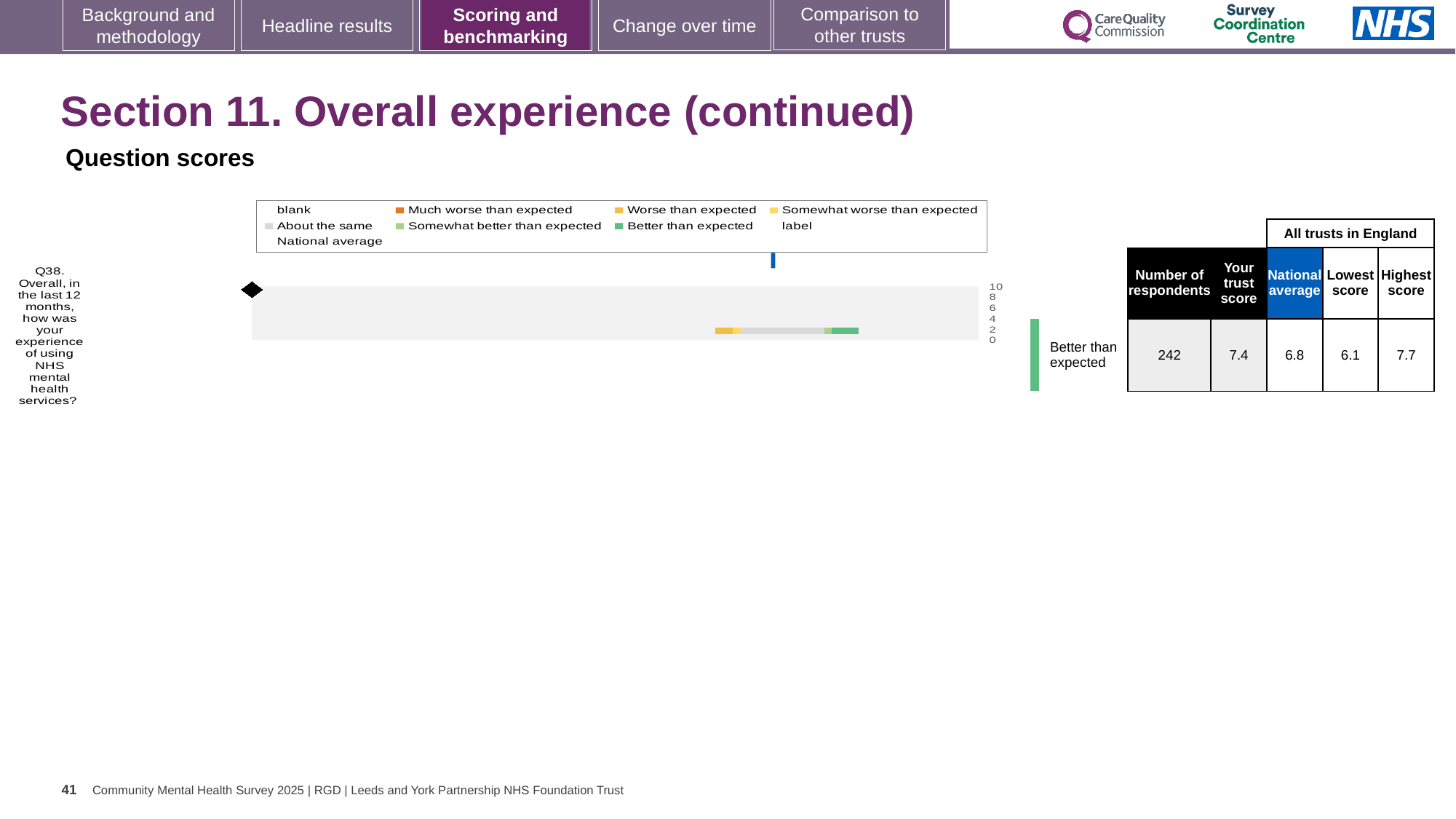
How many respondents answered Q38? 242 What is the lowest score among all trusts in England for Q38? 6.1 What is the highest score among all trusts in England for Q38? 7.7 What kind of chart is used to show the Q38 question score? bar chart How many questions are plotted on the question scores chart? 1 What is the trust's score for Q38 (Overall, in the last 12 months, how was your experience of using NHS mental health services?)? 7.4 Which benchmarking category is the trust's Q38 score placed in? Better than expected What is the difference between the trust's score and the national average for Q38? 0.6 What is the maximum value shown on the score axis of the chart? 10 What is the national average score for Q38? 6.8 What is the difference between the highest and lowest scores among all trusts in England for Q38? 1.6 Which is larger for Q38, the trust's score or the national average? the trust's score